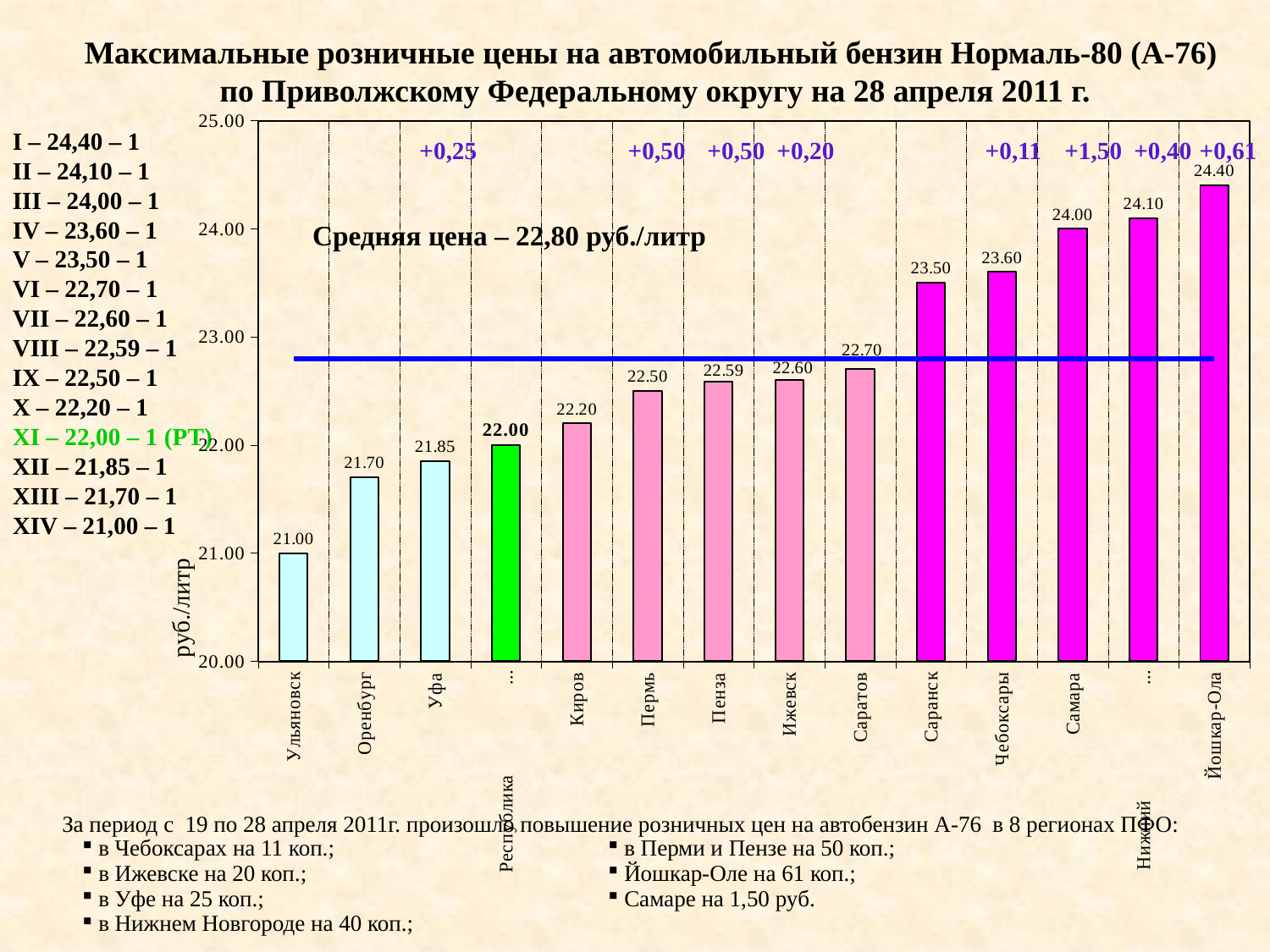
What is the difference between the values for Самара and Киров? 1.80 Which category has the highest value? Йошкар-Ола What is the value for Ульяновск? 21.00 What kind of chart is shown on the slide? bar chart Which is larger, the value for Чебоксары or the value for Саратов? Чебоксары What is the value for Йошкар-Ола? 24.40 How many bars are shown in the chart? 14 What is the value for Саранск? 23.50 Which category has the lowest value? Ульяновск Is the value for Уфа greater or less than 22.00? less Do the values rise or fall from left to right along the x axis? rise What is the value for Пенза? 22.59